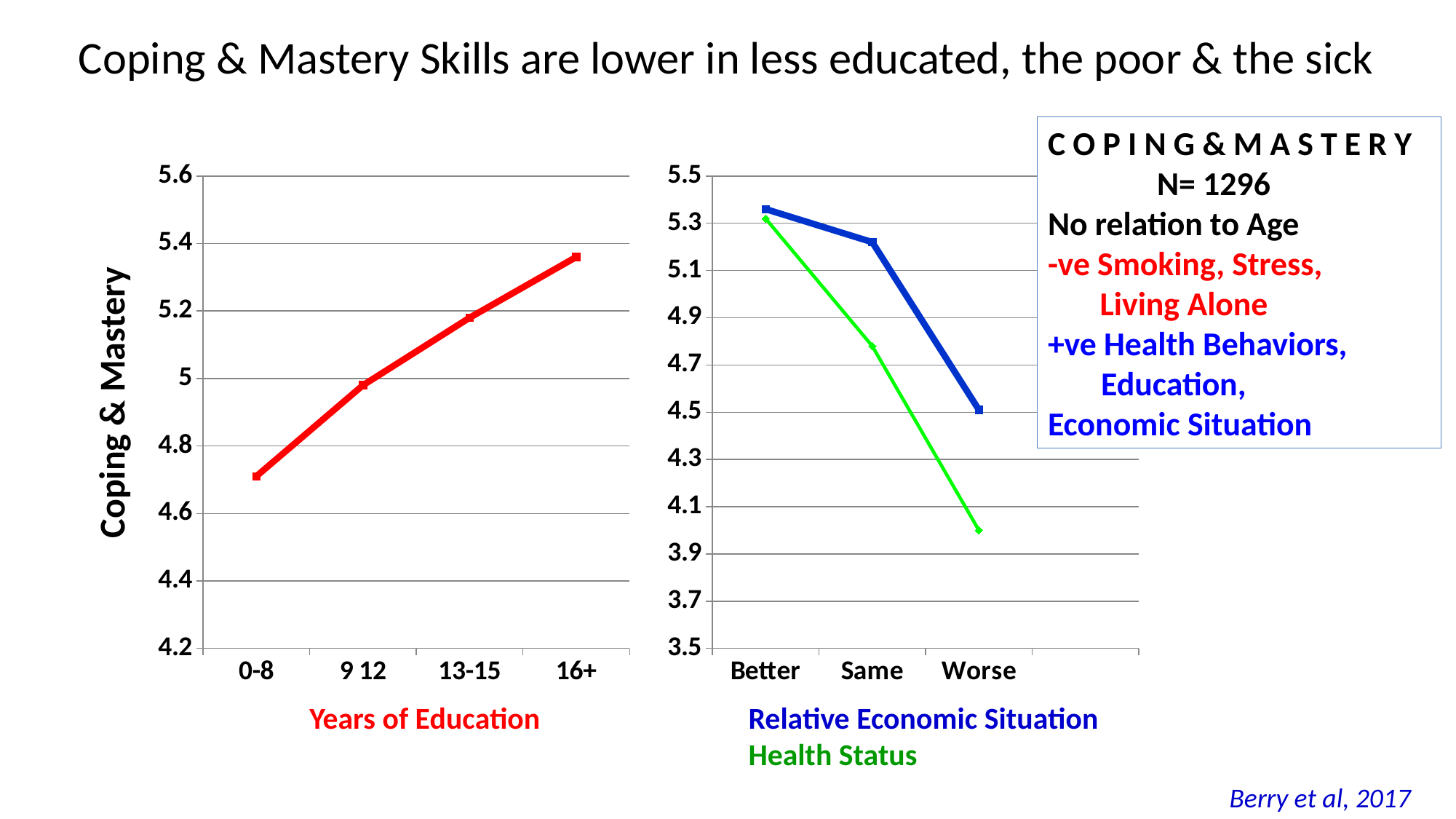
In the right chart, how many lines (series) are plotted? 2 In the right chart, do the values rise or fall moving from Better to Worse? fall In the right chart, which series is drawn in green? Health Status In the left chart (Years of Education), which education category has the highest Coping & Mastery value? 16+ In the left chart (Years of Education), do Coping & Mastery values rise or fall as years of education increase? rise In the right chart, is the Health Status value for Worse greater or less than 4.1? less In the left chart (Years of Education), which education category has the lowest Coping & Mastery value? 0-8 What kind of chart is the left chart (Years of Education)? line chart In the left chart (Years of Education), is the value for 0-8 years greater or less than 4.8? less In the left chart (Years of Education), is the value for 16+ years greater or less than 5.2? greater In the right chart, which is larger for the Same category: Relative Economic Situation or Health Status? Relative Economic Situation In the left chart (Years of Education), how many education categories are shown on the x axis? 4